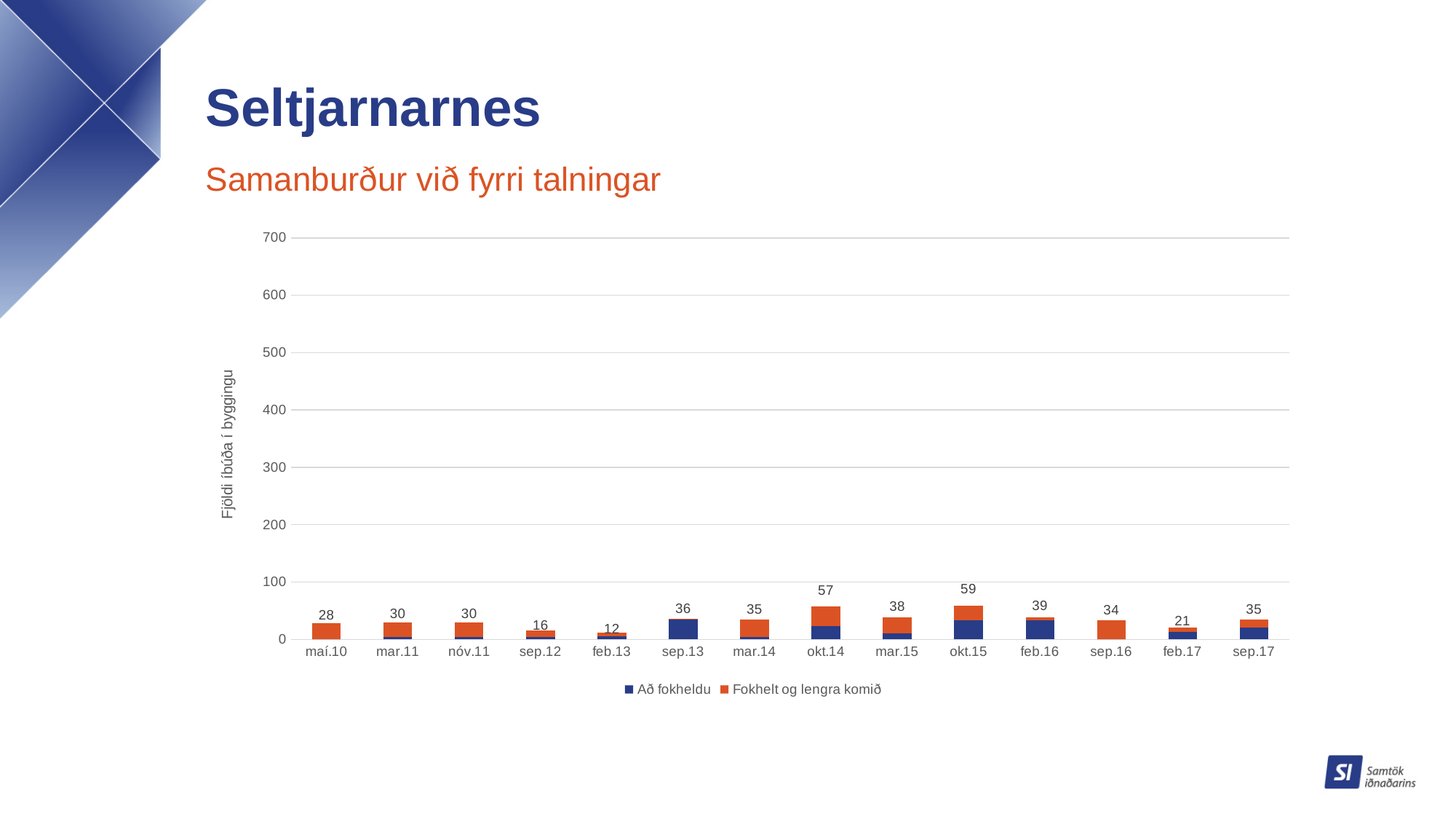
What is the difference between the totals for sep.13 and feb.13? 24 Which period has the lowest total? feb.13 How many periods are shown on the x axis? 14 Is the total for okt.15 greater or less than 100? less How many series does the legend list? 2 What kind of chart is shown on the slide? Stacked bar chart Which has a larger total, okt.14 or mar.15? okt.14 What is the total value labelled for sep.17? 35 What is the total value labelled for feb.13? 12 What is the difference between the totals for okt.15 and okt.14? 2 Which period has the highest total? okt.15 What is the total number of dwellings under construction shown for okt.15? 59